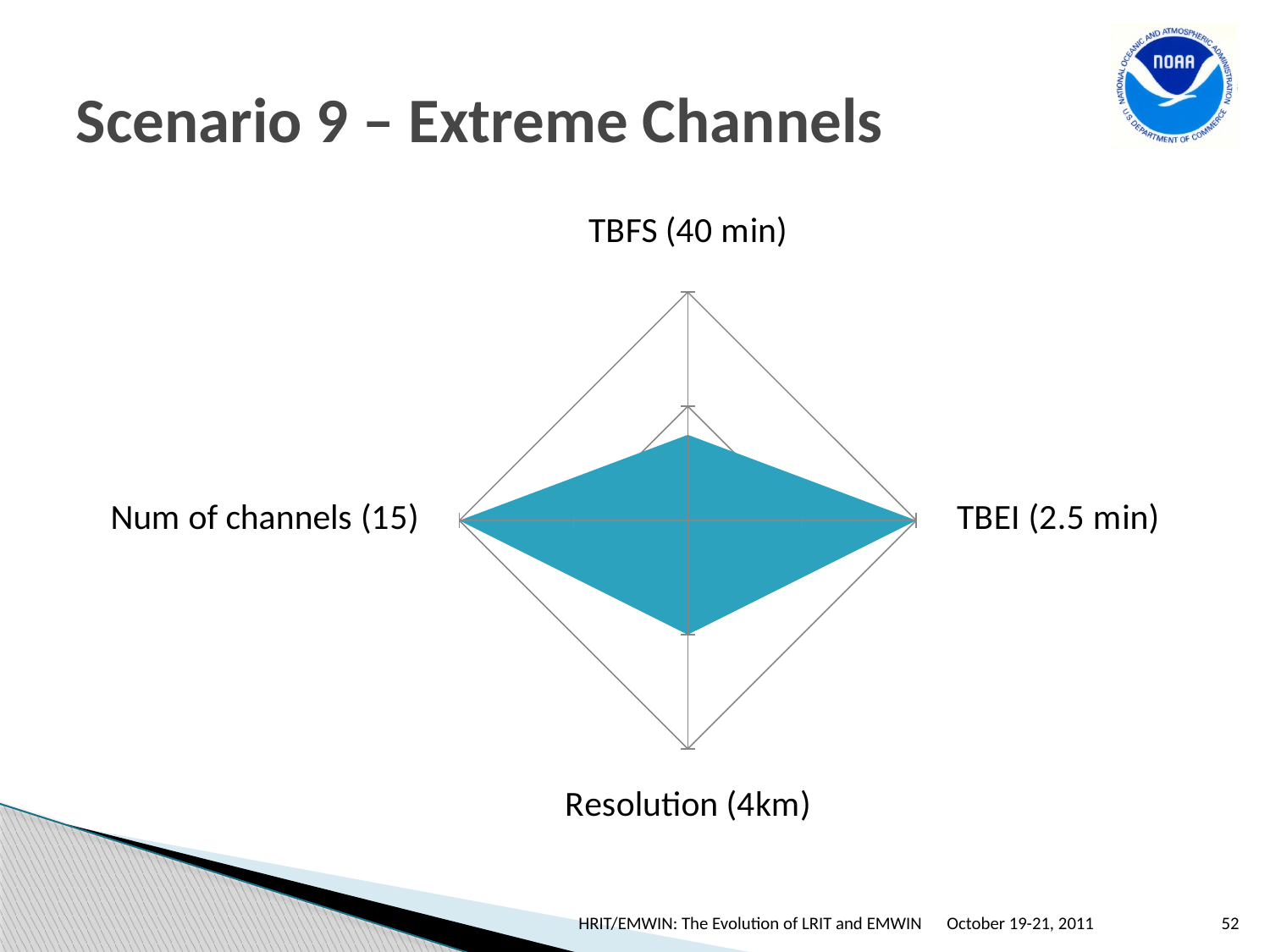
Does the plotted shape extend further along the Num of channels (15) axis or the Resolution (4km) axis? Num of channels (15) Does the plotted shape extend further along the Num of channels (15) axis or the TBFS (40 min) axis? Num of channels (15) Does the plotted shape extend further along the TBEI (2.5 min) axis or the Resolution (4km) axis? TBEI (2.5 min) Which category label appears at the top of the radar chart? TBFS (40 min) What kind of chart is shown on the slide? Radar chart Which category label appears at the bottom of the radar chart? Resolution (4km) How many axes (categories) does the radar chart have? 4 How many data series are plotted on the radar chart? 1